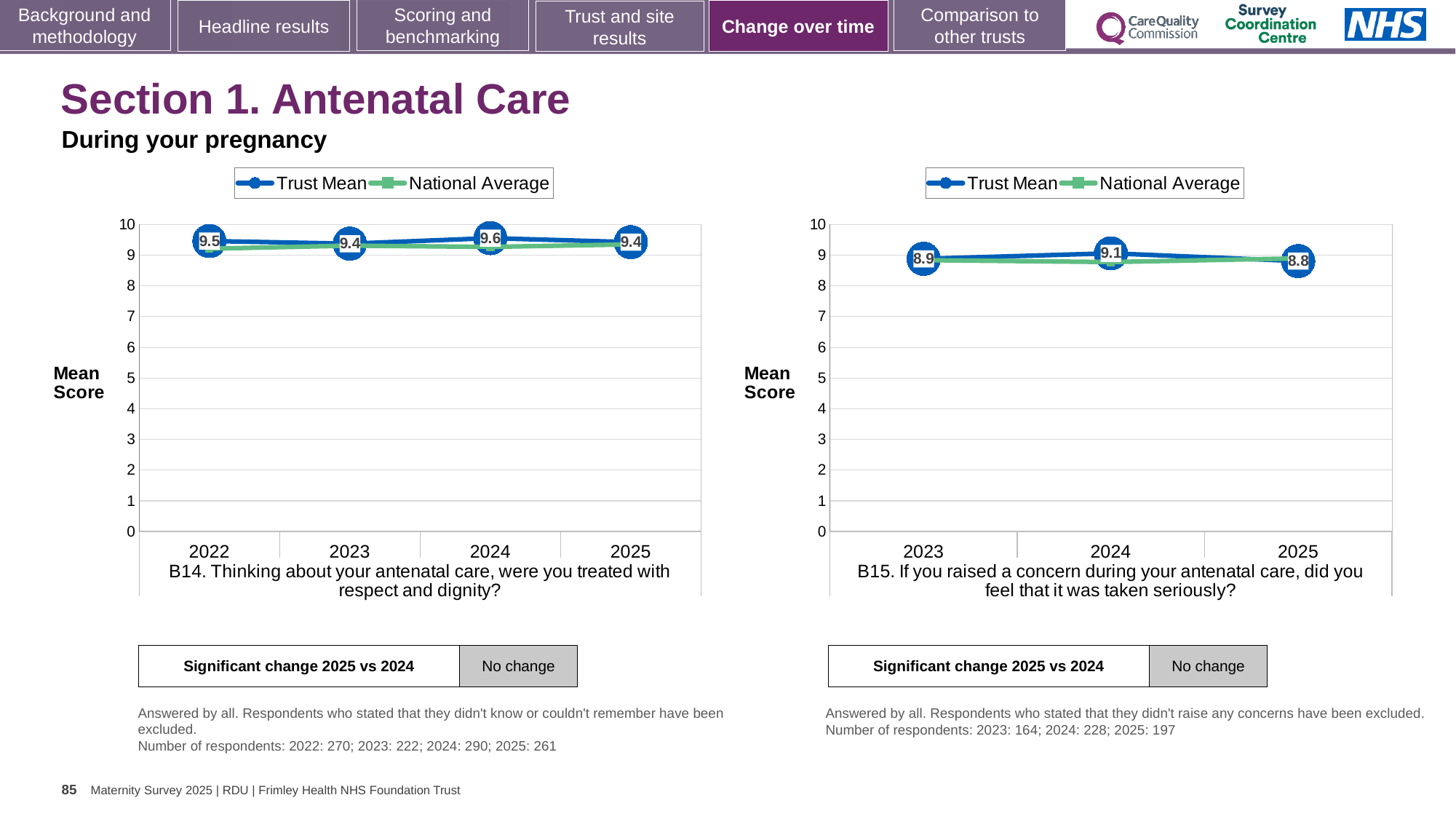
On the B14 chart (left), what is the Trust Mean for 2024? 9.6 What kind of chart is the B15 chart (right)? Line chart On the B15 chart (right), what is the difference between the Trust Mean for 2024 and 2025? 0.3 On the B14 chart (left), which year has the highest Trust Mean? 2024 On the B15 chart (right), which year has the lowest Trust Mean? 2025 On the B15 chart (right), how many series does the legend list? 2 On the B15 chart (right), what is the Trust Mean for 2025? 8.8 On the B14 chart (left), what is the Trust Mean for 2022? 9.5 On the B15 chart (right), what is the Trust Mean for 2024? 9.1 On the B14 chart (left), is the Trust Mean for 2023 or 2024 larger? 2024 On the B14 chart (left), how many years are plotted on the x axis? 4 On the B15 chart (right), is the National Average for 2023 greater or less than 5? greater